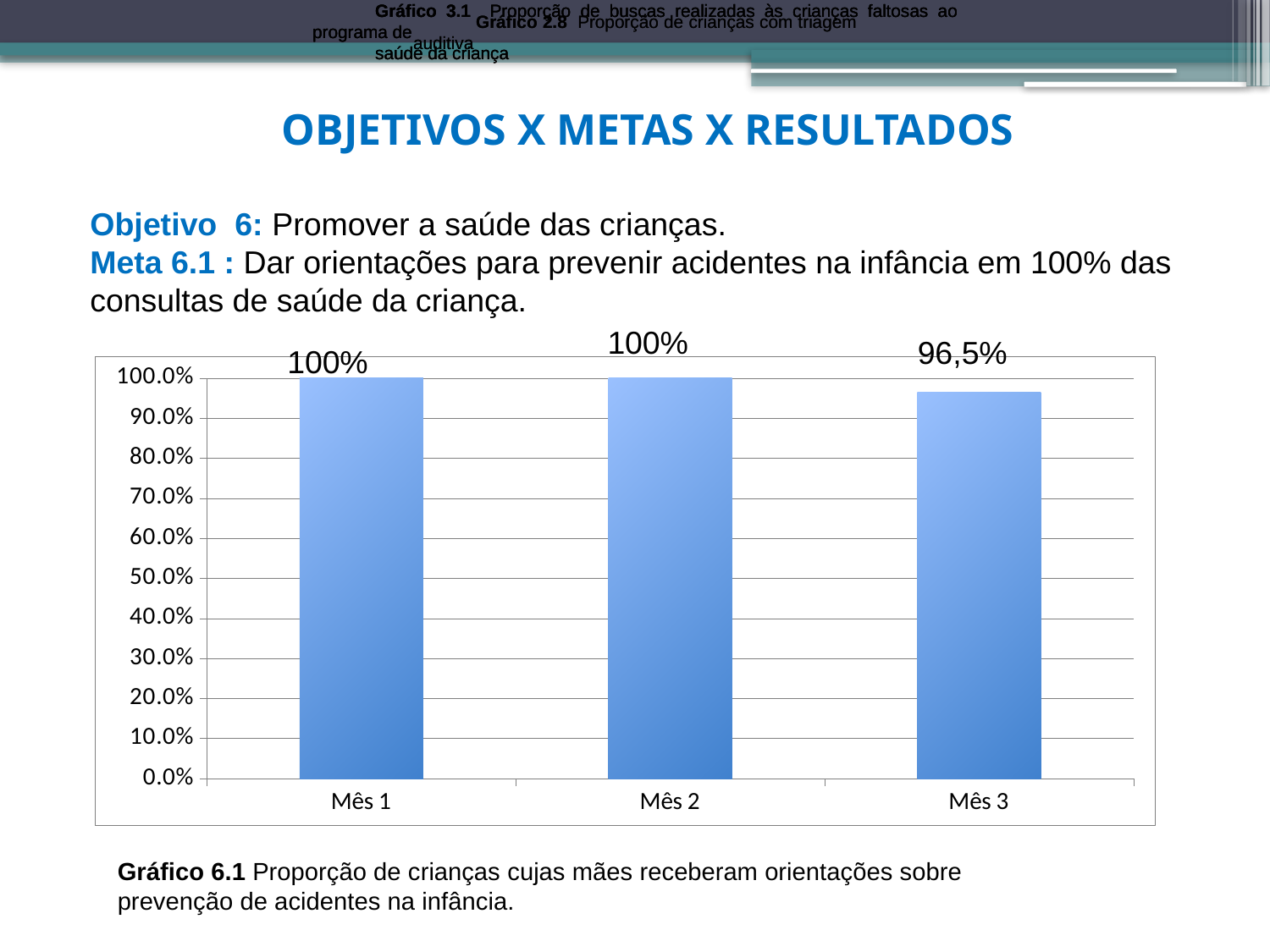
What is the highest tick value shown on the y axis? 100.0% What is the value for Mês 2? 100% What kind of chart is shown on the slide? bar chart What is the number of the chart given in the caption below it? Gráfico 6.1 How many categories are shown on the x axis? 3 Which is larger, the value for Mês 2 or the value for Mês 3? Mês 2 Which month has the lowest value? Mês 3 What is the value for Mês 3? 96,5% Do the values rise or fall from Mês 2 to Mês 3? fall What is the difference between the values for Mês 1 and Mês 3? 3,5% What is the value for Mês 1? 100% Is the value for Mês 3 greater or less than 90.0%? greater